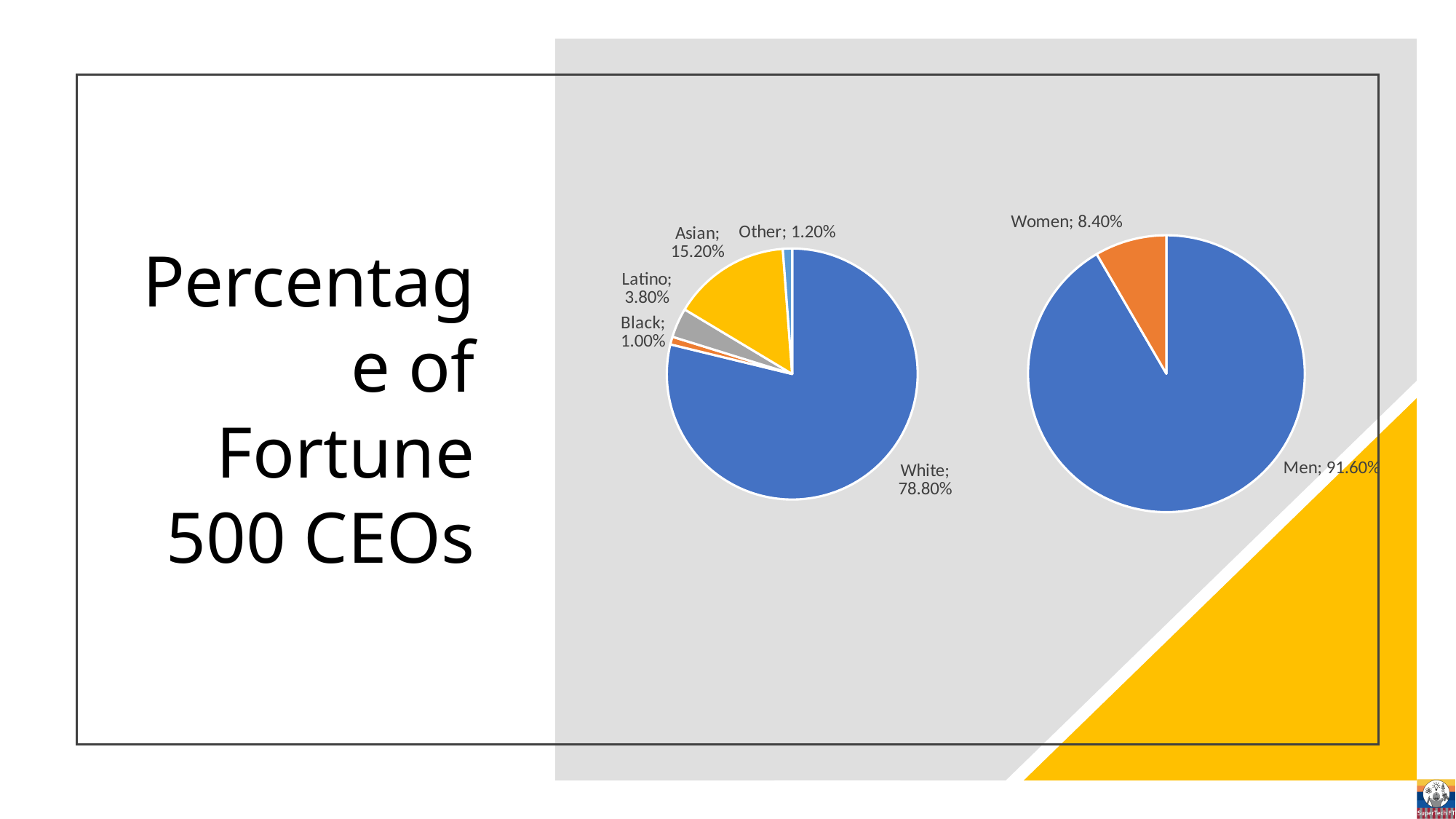
How many categories does the left pie chart show? 5 In the left pie chart, what is the value for Asian? 15.20% In the left pie chart, what is the value for White? 78.80% In the left pie chart, what is the difference between the Asian and Latino values? 11.40% In the right pie chart, what is the value for Women? 8.40% In the left pie chart, which is larger, Other or Black? Other In the right pie chart, what is the value for Men? 91.60% What kind of chart is the right chart? Pie chart In the left pie chart, which category has the largest slice? White In the right pie chart, what is the difference between the Men and Women values? 83.20% In the left pie chart, which category has the smallest slice? Black In the left pie chart, what is the value for Latino? 3.80%